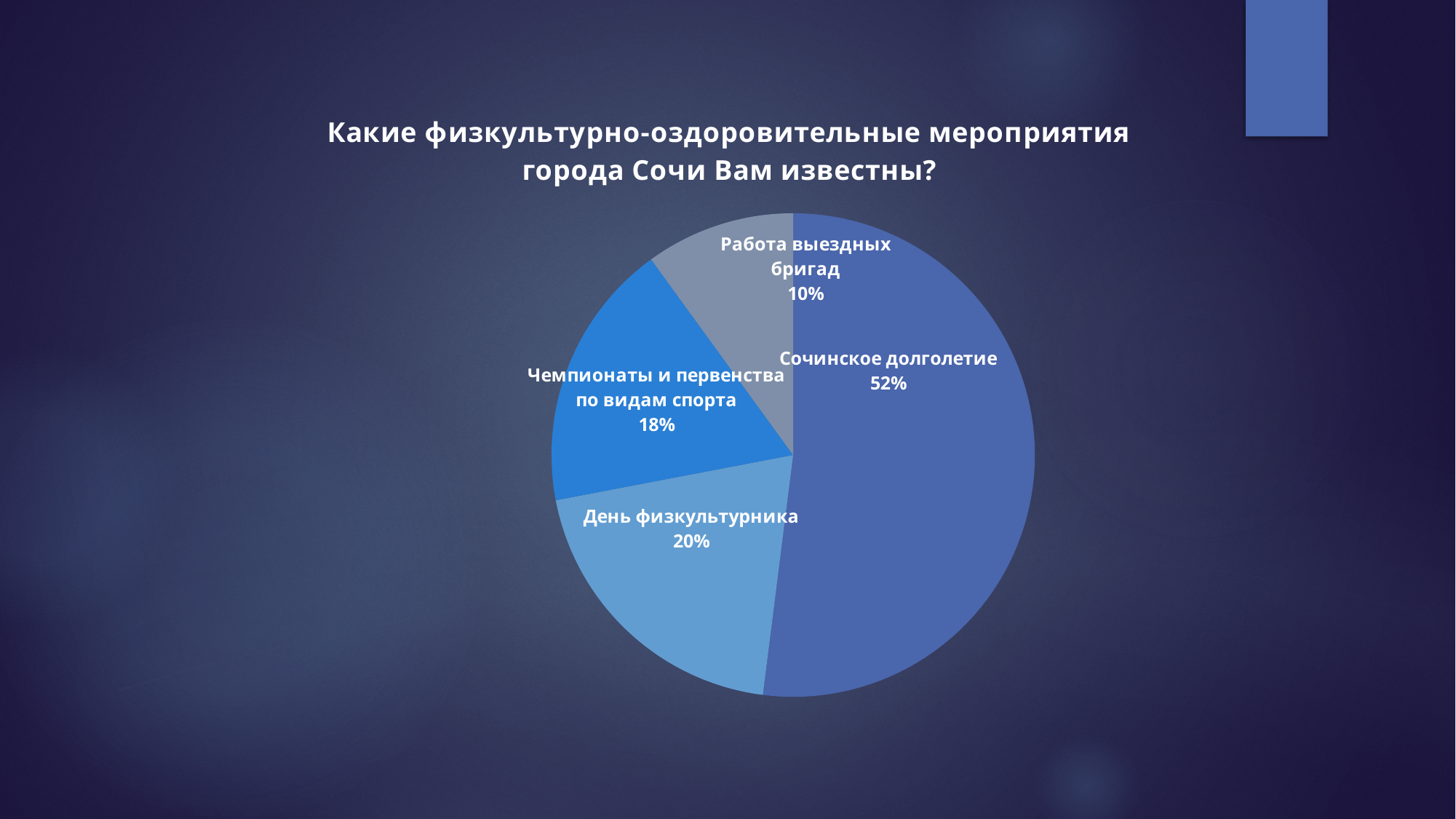
What is the title of the chart? Какие физкультурно-оздоровительные мероприятия города Сочи Вам известны? What kind of chart is shown on the slide? Pie chart How many slices does the pie chart have? 4 What is the value shown for "Работа выездных бригад"? 10% Which category has the largest slice of the pie? Сочинское долголетие What is the difference in percentage points between "Сочинское долголетие" and "День физкультурника"? 32 What share of the pie does "Сочинское долголетие" have? 52% What is the difference in percentage points between "Чемпионаты и первенства по видам спорта" and "Работа выездных бригад"? 8 What is the value shown for "День физкультурника"? 20% Which is larger: "День физкультурника" or "Чемпионаты и первенства по видам спорта"? День физкультурника Which category has the smallest slice of the pie? Работа выездных бригад What is the value shown for "Чемпионаты и первенства по видам спорта"? 18%